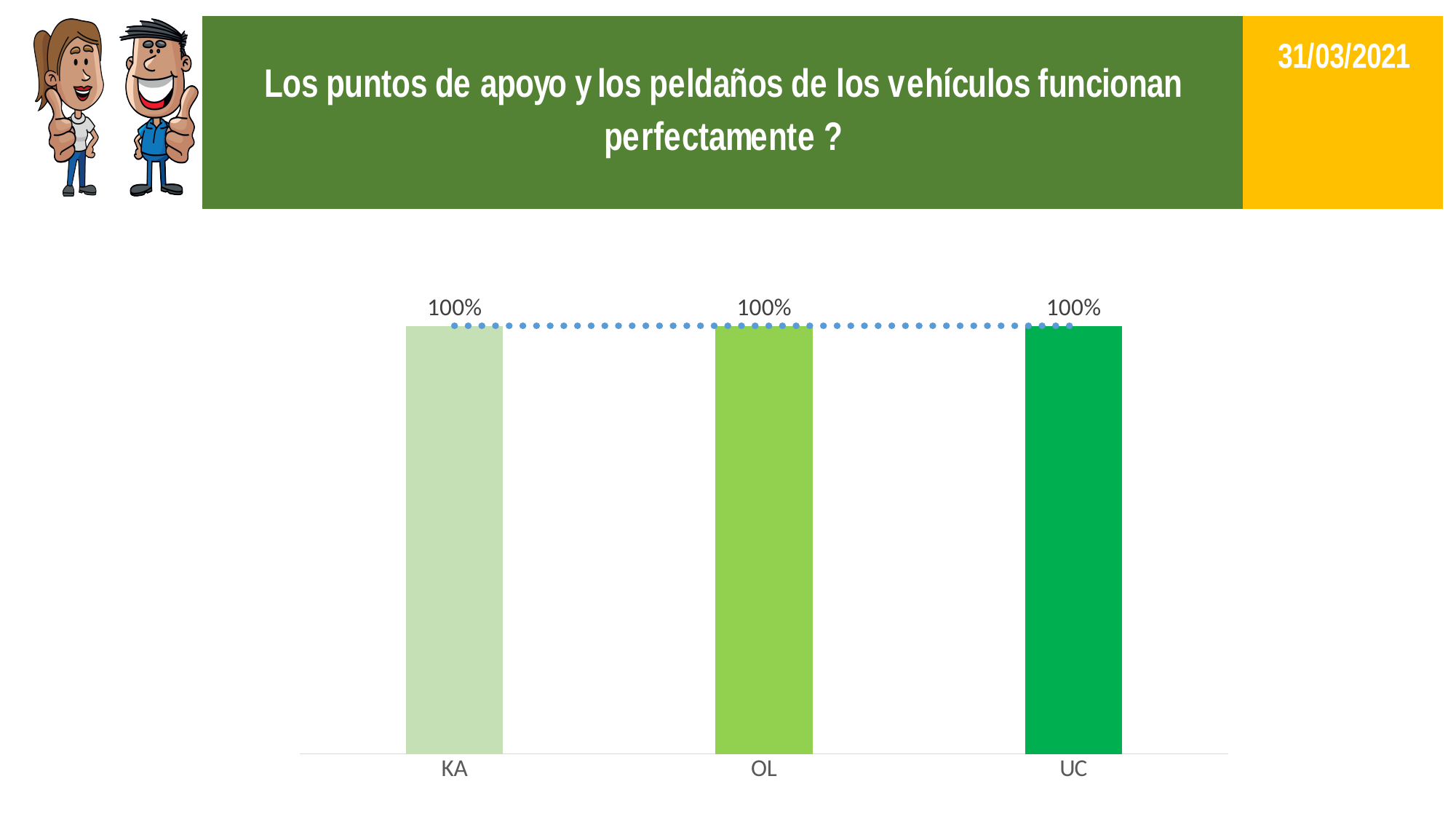
What is the label of the first category on the x axis? KA What is the value for UC? 100% What is the label of the last category on the x axis? UC What is the difference between the values for KA and UC? 0% What is the value for OL? 100% How many categories are shown on the x axis? 3 What kind of chart is shown on the slide? Bar chart Do the values rise, fall or stay the same from KA to UC? Stay the same What is the value for KA? 100%